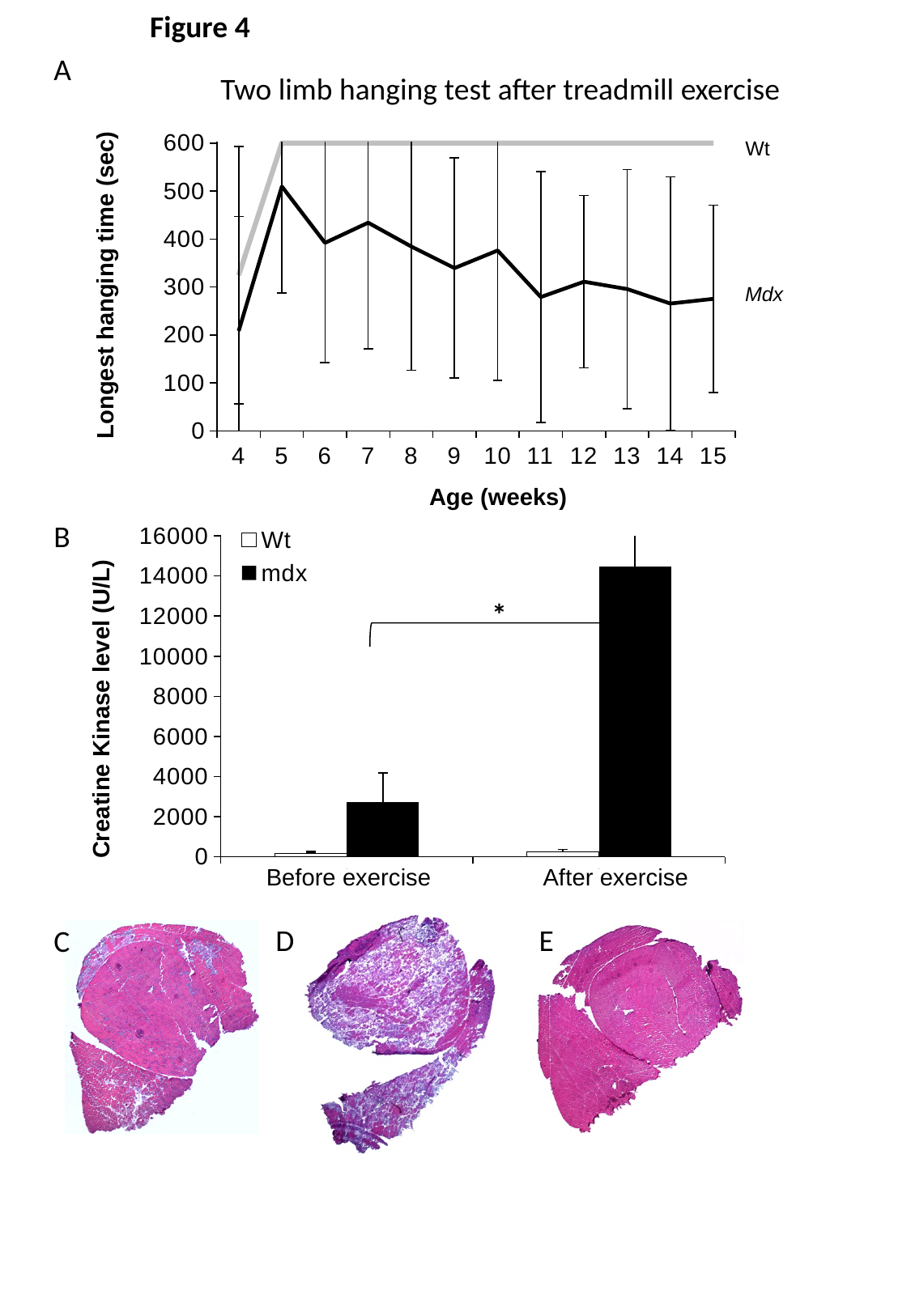
In chart A, at which age does the Mdx line reach its highest value? 5 weeks In chart A, which series has the larger value at 12 weeks, Wt or Mdx? Wt In chart A, how many series are plotted? 2 In chart B, which bar is the highest? mdx, After exercise In chart B, is the mdx value before exercise greater or less than 4000? less In chart A, does the Mdx line generally rise or fall from 5 weeks to 15 weeks? fall In chart A, what is the longest hanging time for Wt at 10 weeks? 600 What type of chart is chart A, 'Two limb hanging test after treadmill exercise'? line chart In chart A, at which age is the Mdx value lowest? 4 weeks In chart A, how many age points are shown on the x axis? 12 In chart A, is the Mdx value at 15 weeks greater or less than 300? less What type of chart is chart B, the Creatine Kinase level chart? bar chart